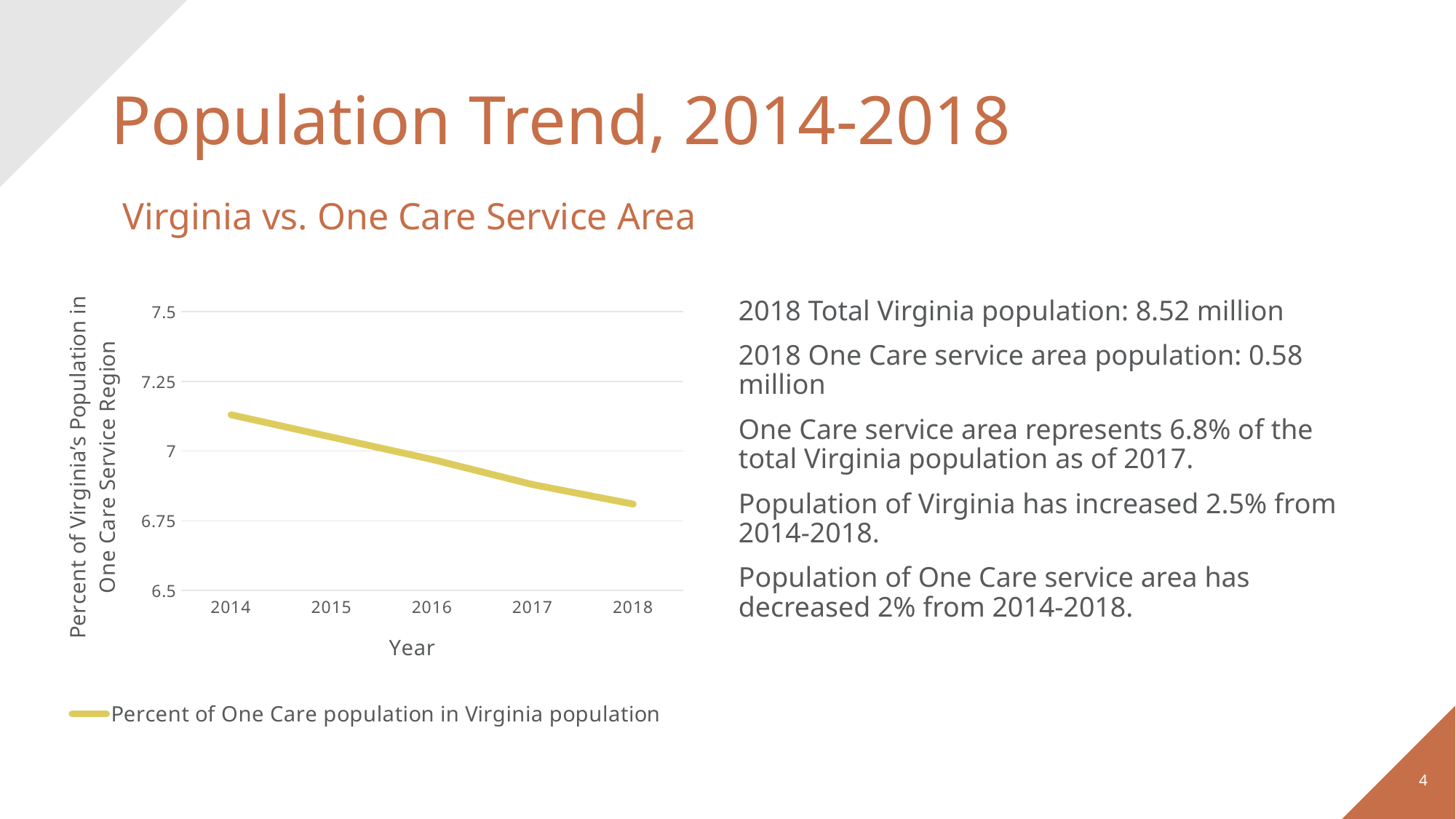
Is the value for 2017 greater or less than 7? less How many years are plotted on the x axis of the chart? 5 Which year has the larger value, 2014 or 2018? 2014 Which year has the highest value on the chart? 2014 Which year has the lowest value on the chart? 2018 Is the value for 2018 greater or less than 7? less How many series does the chart's legend list? 1 Do the values rise or fall from 2014 to 2018? fall What kind of chart is shown on the slide? line chart Is the value for 2014 greater or less than 7.25? less What is the label of the series shown in the chart's legend? Percent of One Care population in Virginia population